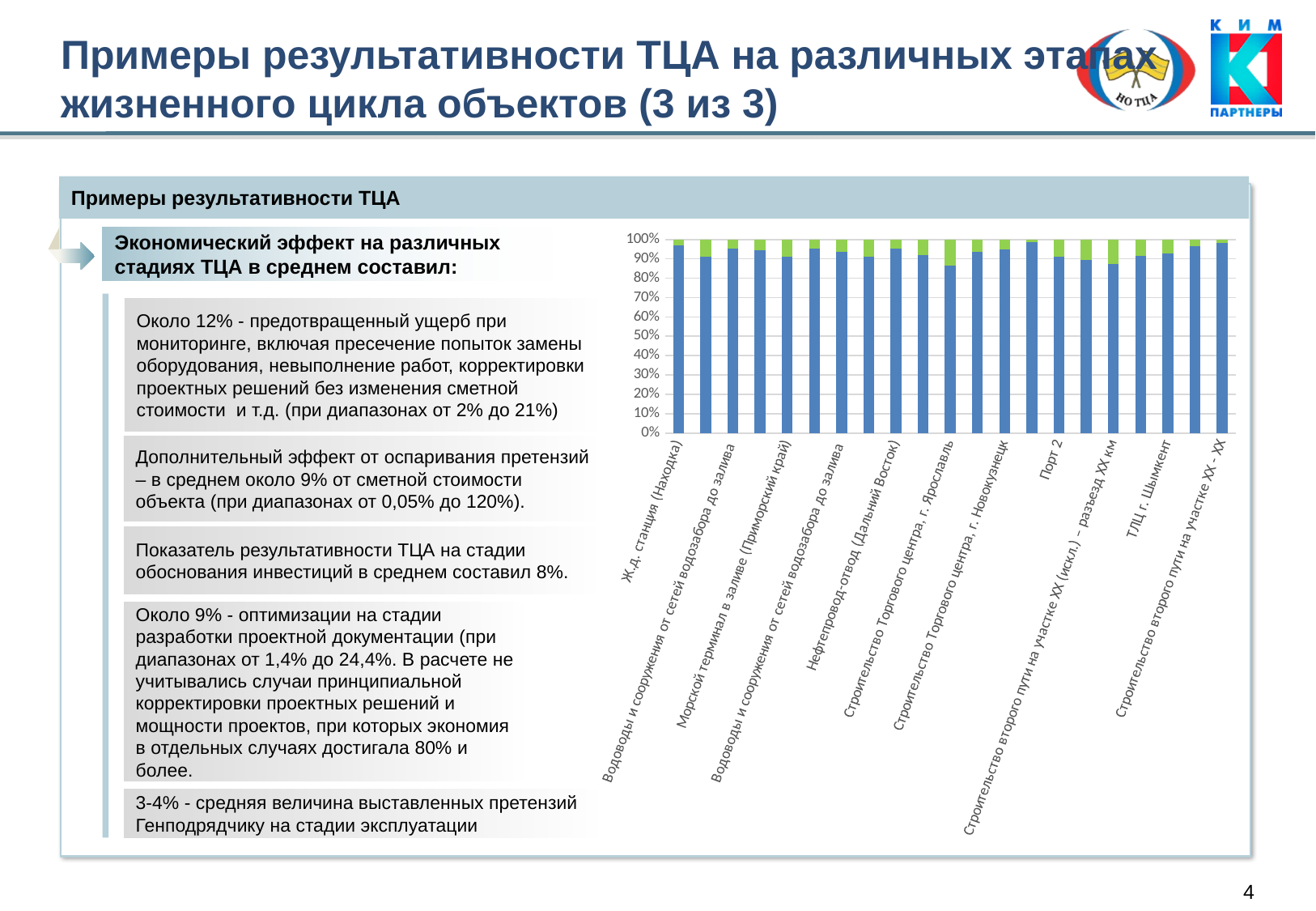
Is the blue segment for Нефтепровод-отвод (Дальний Восток) greater or less than 90%? greater Is the blue segment for Строительство Торгового центра, г. Ярославль greater or less than 90%? less Which has the larger green segment: Строительство Торгового центра, г. Ярославль or Порт 2? Строительство Торгового центра, г. Ярославль How many category labels are printed along the x axis of the chart? 11 What is the total height of the stacked bar for Порт 2? 100% What is the highest value shown on the chart's y axis? 100% Is the blue segment for Строительство второго пути на участке XX (искл.) – разъезд XX км greater or less than 90%? less Which has the larger blue segment: Ж.д. станция (Находка) or Строительство Торгового центра, г. Ярославль? Ж.д. станция (Находка) What two colours are used for the segments of the stacked bars? blue and green What kind of chart is shown on the slide? stacked bar chart